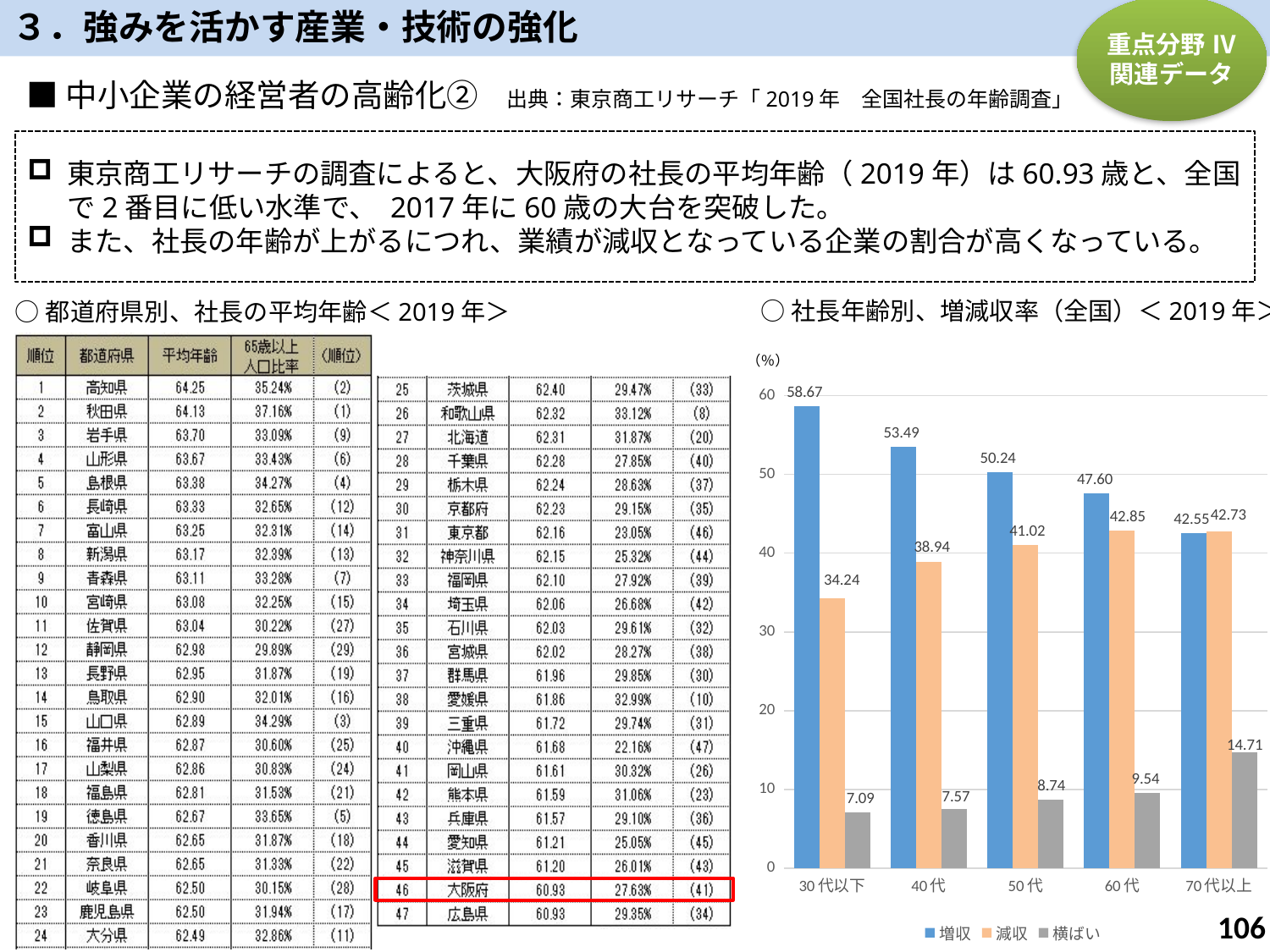
In the 社長年齢別、増減収率 chart, what is the difference between the 増収 values for 30代以下 and 70代以上? 16.12 In the 社長年齢別、増減収率 chart, does the 減収 value rise or fall as the age group increases from 30代以下 to 70代以上? rise In the 社長年齢別、増減収率 chart, what colour are the 減収 bars? orange In the 社長年齢別、増減収率 chart, which is larger for 50代: 増収 or 減収? 増収 In the 社長年齢別、増減収率 chart, how many age groups are shown on the x axis? 5 In the 社長年齢別、増減収率 chart, what is the 減収 value for 60代? 42.85 In the 社長年齢別、増減収率 chart, which age group has the lowest 横ばい value? 30代以下 In the 社長年齢別、増減収率 chart, what is the 横ばい value for 70代以上? 14.71 In the 社長年齢別、増減収率 chart, how many series does the legend list? 3 What type of chart is shown on the right side of the slide (社長年齢別、増減収率)? bar chart In the 社長年齢別、増減収率 chart, what is the 増収 value for 30代以下? 58.67 In the 社長年齢別、増減収率 chart, which age group has the highest 増収 value? 30代以下